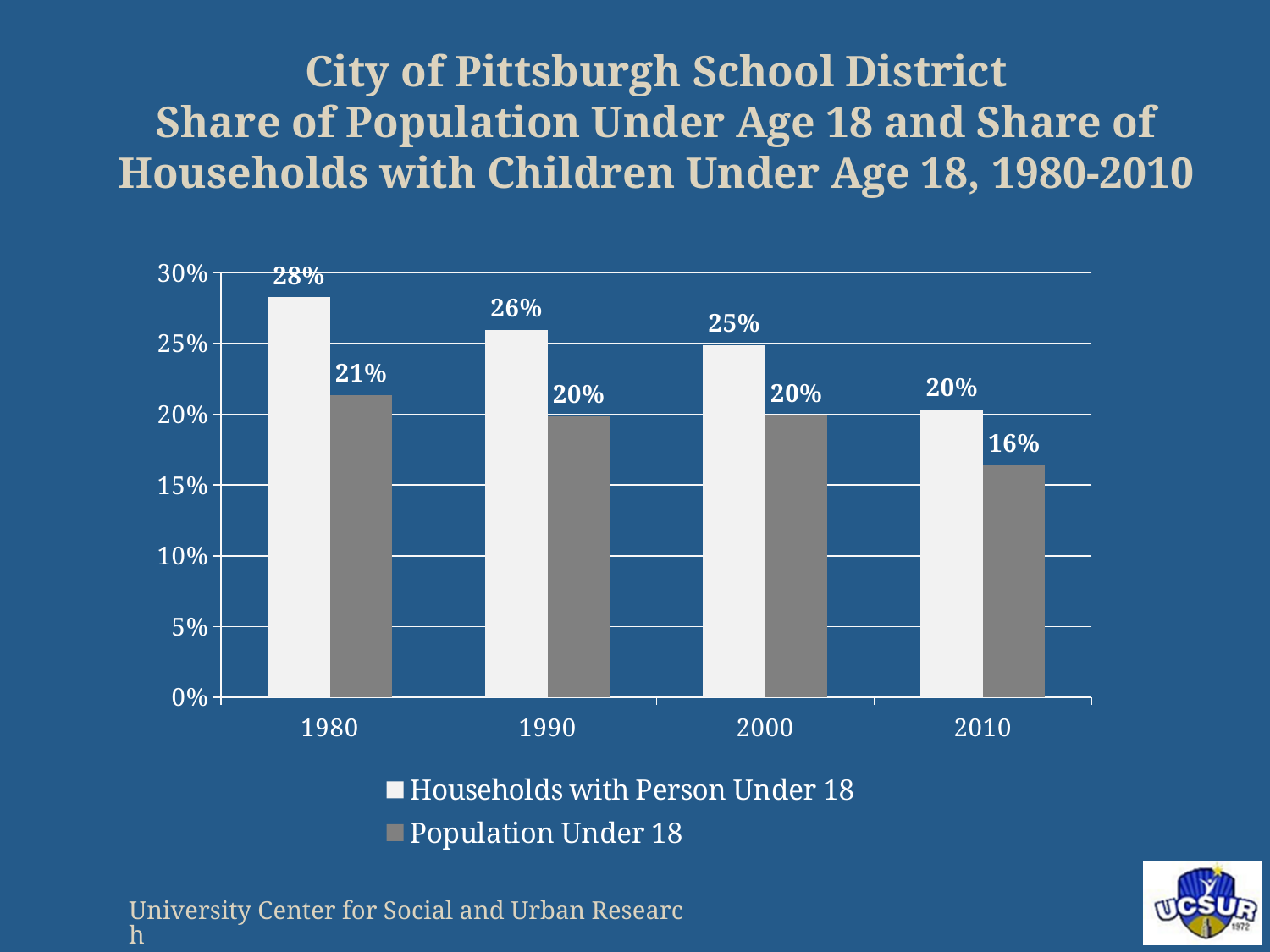
How many years are shown on the x axis? 4 Which is larger in 2000: Households with Person Under 18 or Population Under 18? Households with Person Under 18 What is the difference between Households with Person Under 18 and Population Under 18 in 1980? 7% What kind of chart is shown on the slide? Bar chart Does the Households with Person Under 18 share rise or fall from 1980 to 2010? Fall In which year is the Population Under 18 share lowest? 2010 What is the value for Population Under 18 in 2010? 16% Is the value for Population Under 18 in 2010 greater or less than 20%? less In which year is the Households with Person Under 18 share highest? 1980 What is the value for Population Under 18 in 1990? 20% What is the value for Households with Person Under 18 in 1980? 28% How many series does the legend list? 2